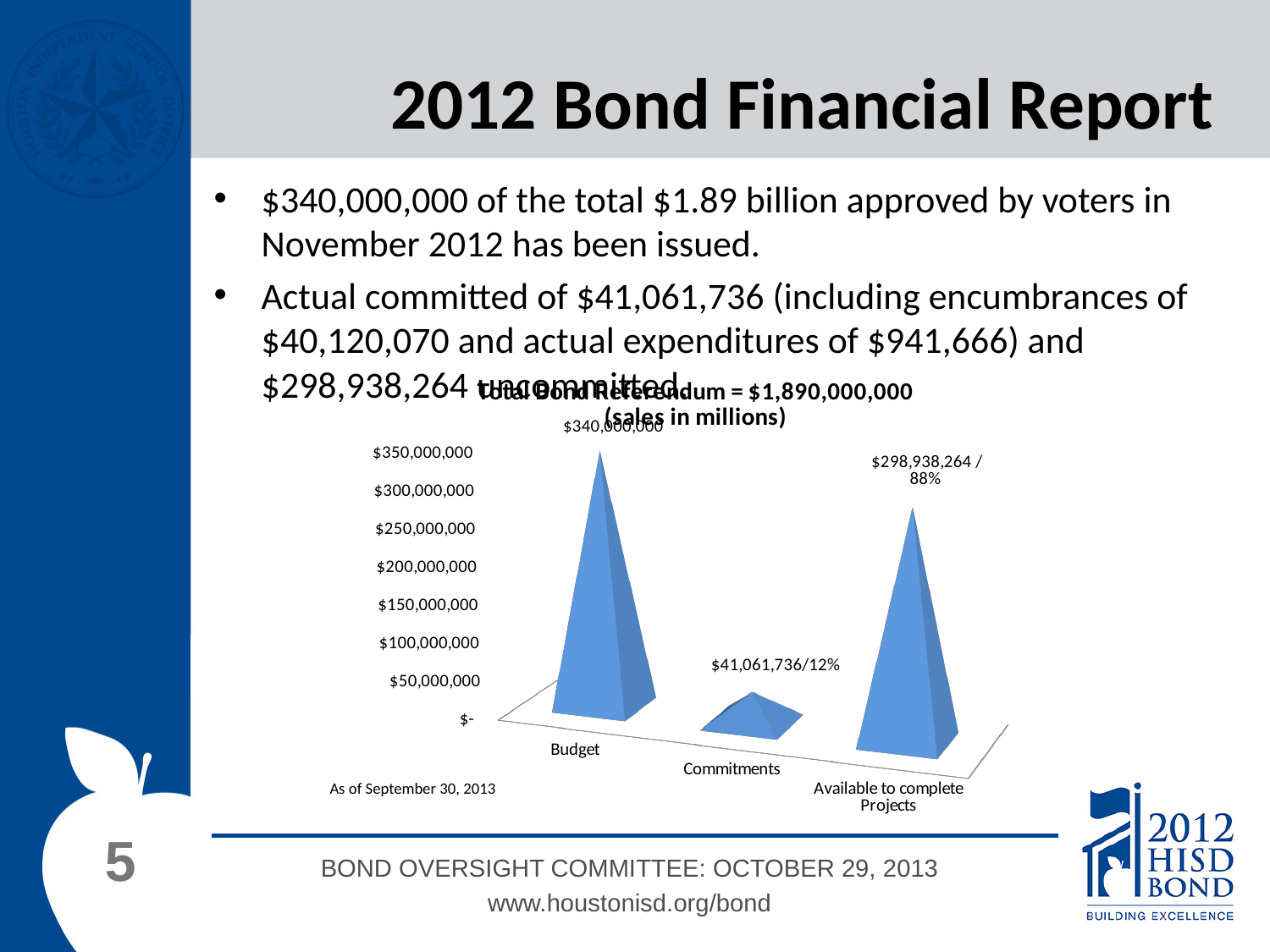
What date is the chart's data as of, according to the note below the chart? September 30, 2013 What is the value for Budget? $340,000,000 Which category has the lowest value? Commitments What is the difference between the Available to complete Projects value and the Commitments value? $257,876,528 What is the value for Commitments? $41,061,736 How many categories are shown on the x axis? 3 What percentage share is shown for Commitments? 12% What is the difference between the Budget value and the Commitments value? $298,938,264 Is the value for Commitments greater or less than $50,000,000? less What is the value for Available to complete Projects? $298,938,264 Which is larger, Commitments or Available to complete Projects? Available to complete Projects Which category has the highest value? Budget